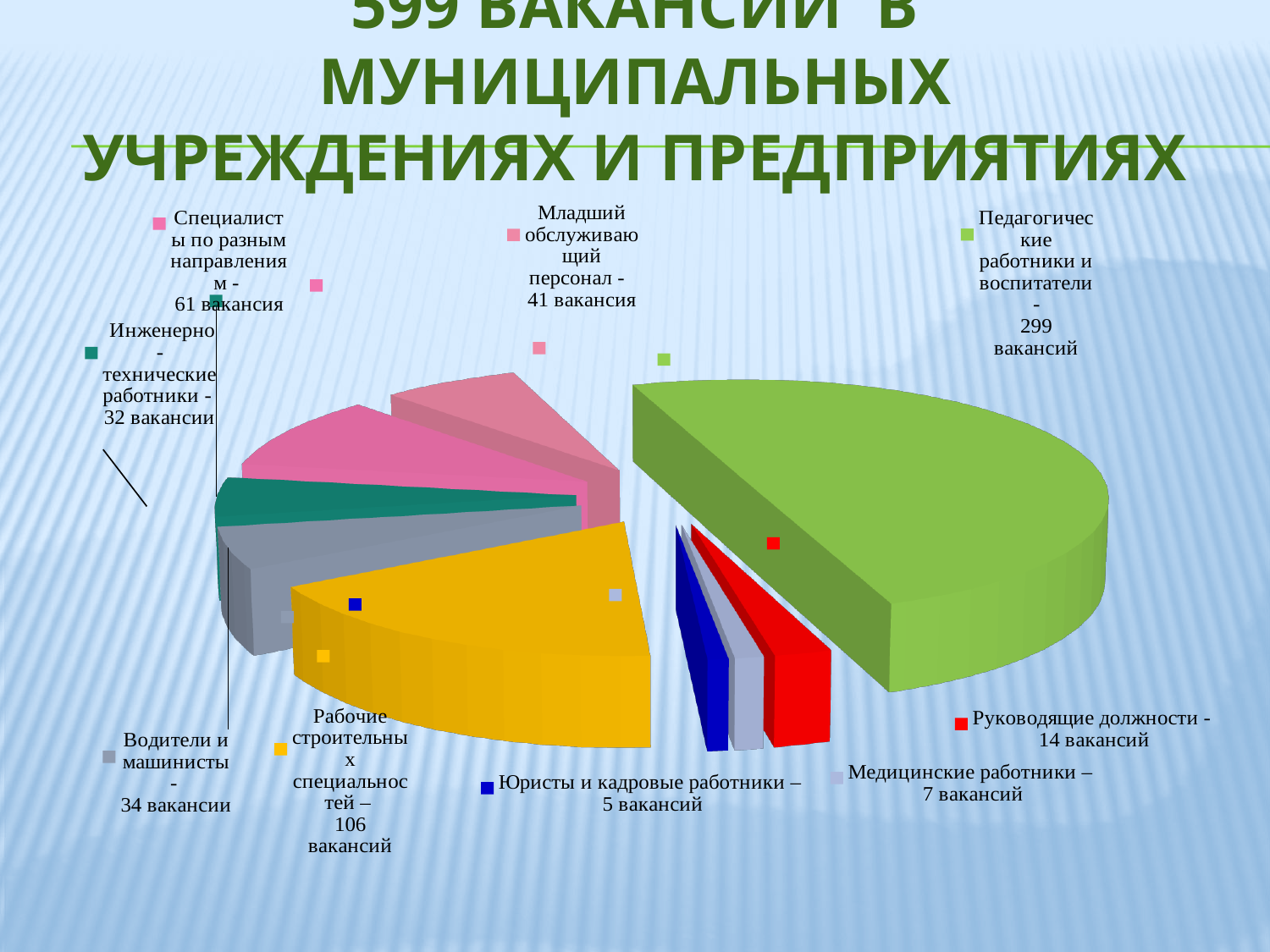
How many categories does the pie chart show? 9 Which category has the smallest number of vacancies? Юристы и кадровые работники What kind of chart is shown on the slide? pie chart What colour is the slice for Руководящие должности? red Which has more vacancies: Водители и машинисты or Инженерно-технические работники? Водители и машинисты What is the difference between the vacancies for Педагогические работники и воспитатели and Рабочие строительных специальностей? 193 How many vacancies are there for Младший обслуживающий персонал? 41 вакансия How many vacancies are there for Медицинские работники? 7 вакансий What is the total number of vacancies across all categories in the chart? 599 How many vacancies are there for Рабочие строительных специальностей? 106 вакансий How many vacancies are there for Педагогические работники и воспитатели? 299 вакансий Which category has the largest number of vacancies? Педагогические работники и воспитатели